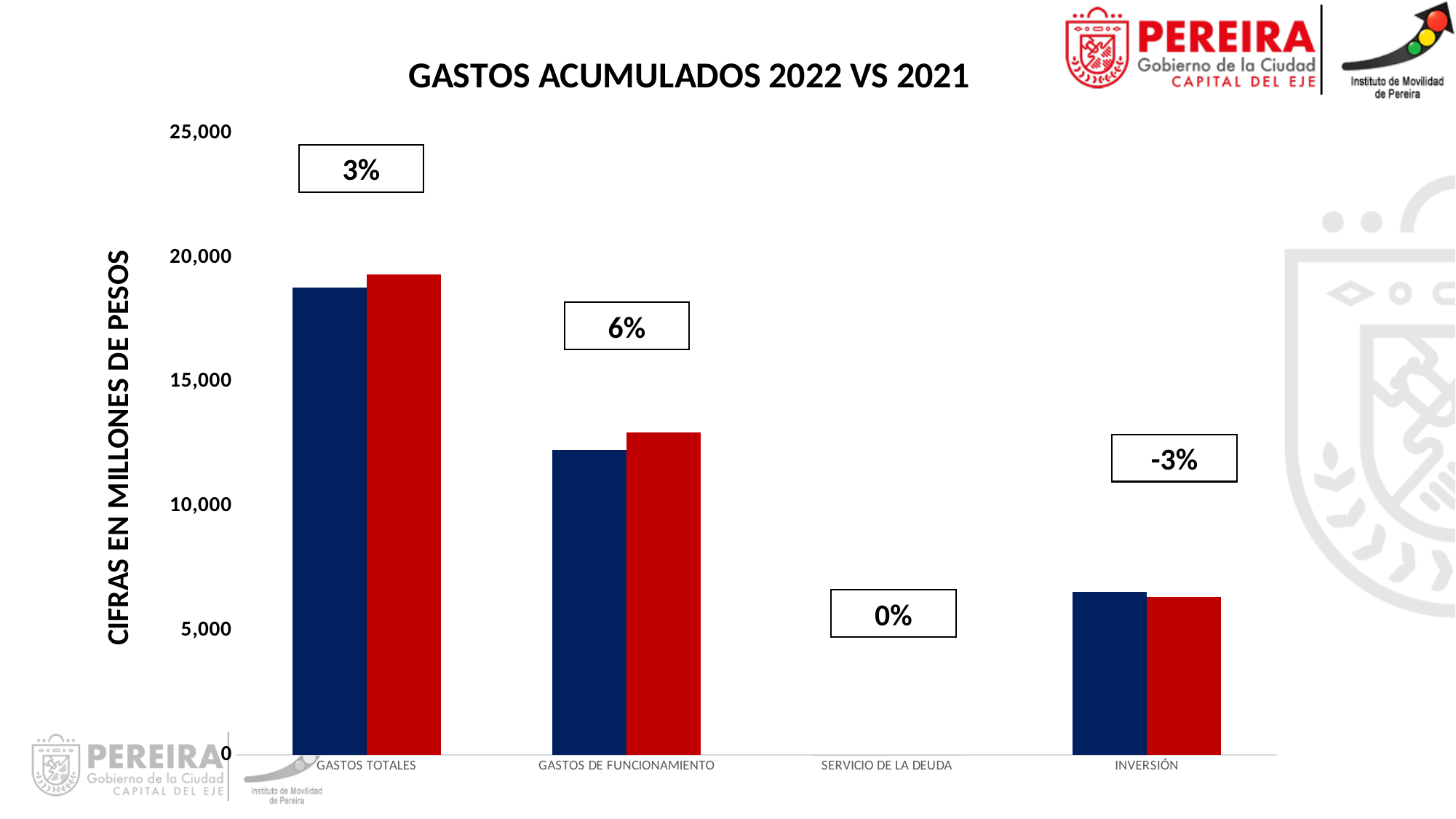
What is the label on the vertical axis of the chart? CIFRAS EN MILLONES DE PESOS What is the title of the chart? GASTOS ACUMULADOS 2022 VS 2021 Which category has the lowest percentage label in the chart? INVERSIÓN How many categories are shown on the x axis of the chart? 4 Which category has the tallest bars in the chart? GASTOS TOTALES What kind of chart is shown on the slide? bar chart What percentage label is shown above the GASTOS DE FUNCIONAMIENTO bars? 6% What percentage label is shown for SERVICIO DE LA DEUDA? 0% What percentage label is shown for INVERSIÓN? -3% What percentage label is shown above the GASTOS TOTALES bars? 3% Is the value of the red bar for INVERSIÓN greater or less than 10,000? less Is the value of the blue bar for GASTOS TOTALES greater or less than 15,000? greater